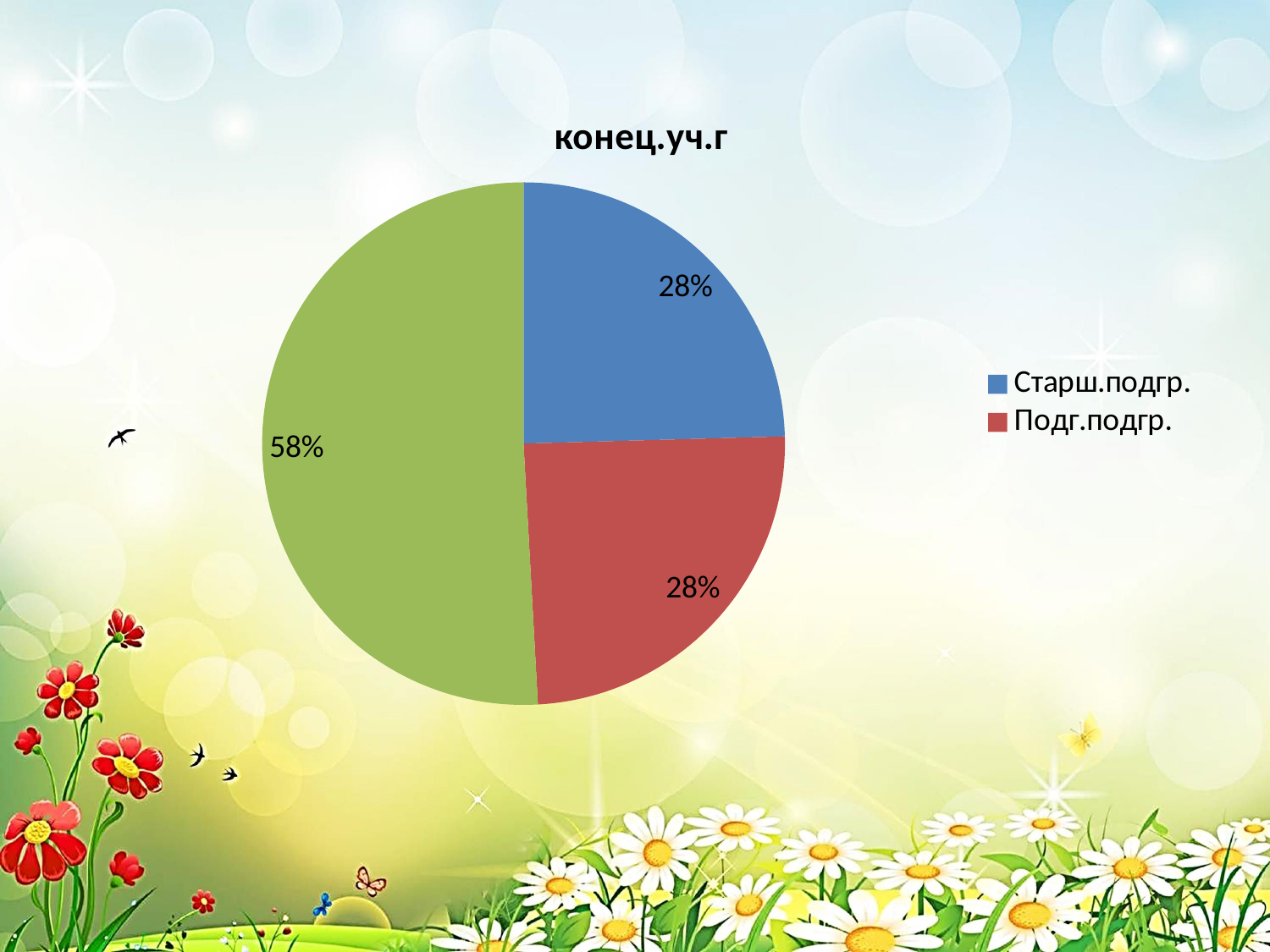
Is the share for Подг.подгр. greater or less than 50%? less Is the largest slice greater or less than 50% of the pie? greater How many entries does the legend list? 2 By how many percentage points is the largest slice bigger than the Старш.подгр. slice? 30 What is the title of the chart? конец.уч.г What colour is the slice for Старш.подгр.? blue How many slices does the pie chart have? 3 What kind of chart is shown on the slide? pie chart What percentage is shown for Подг.подгр.? 28% What percentage is shown for Старш.подгр.? 28% What percentage is shown on the largest slice of the pie? 58%